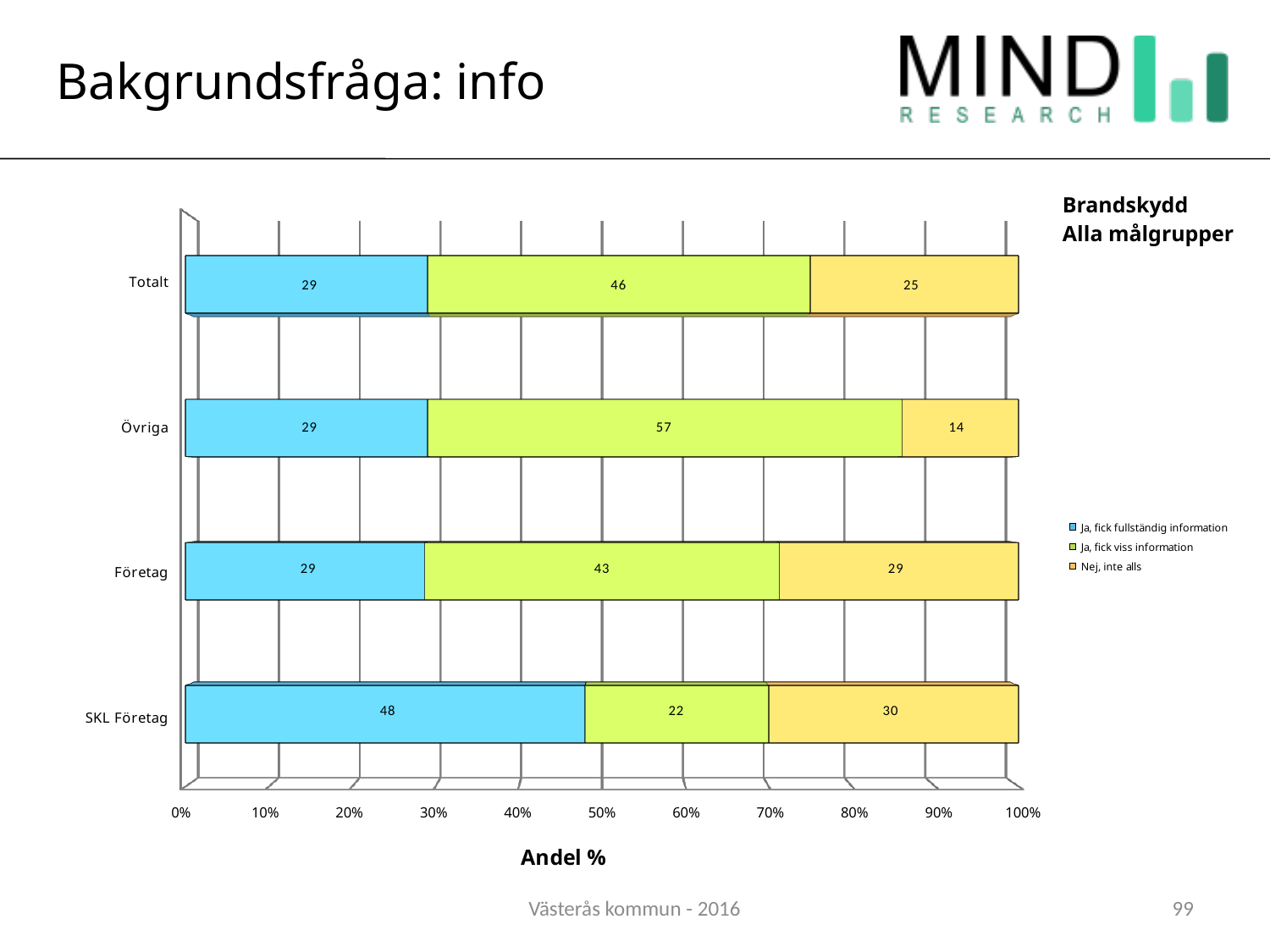
What is the value of "Nej, inte alls" for SKL Företag? 30 What is the label of the x axis? Andel % What is the value of "Ja, fick viss information" for Övriga? 57 What is the difference between the "Ja, fick viss information" values for Övriga and SKL Företag? 35 Which category has the lowest value for "Nej, inte alls"? Övriga What kind of chart is shown on the slide? Stacked bar chart How many series does the legend list? 3 How many categories are shown on the y axis? 4 What is the value of "Ja, fick fullständig information" for Totalt? 29 Which is larger: the "Nej, inte alls" value for Företag or for Totalt? Företag Which category has the highest value for "Ja, fick fullständig information"? SKL Företag What is the total of the stacked bar for Företag? 101